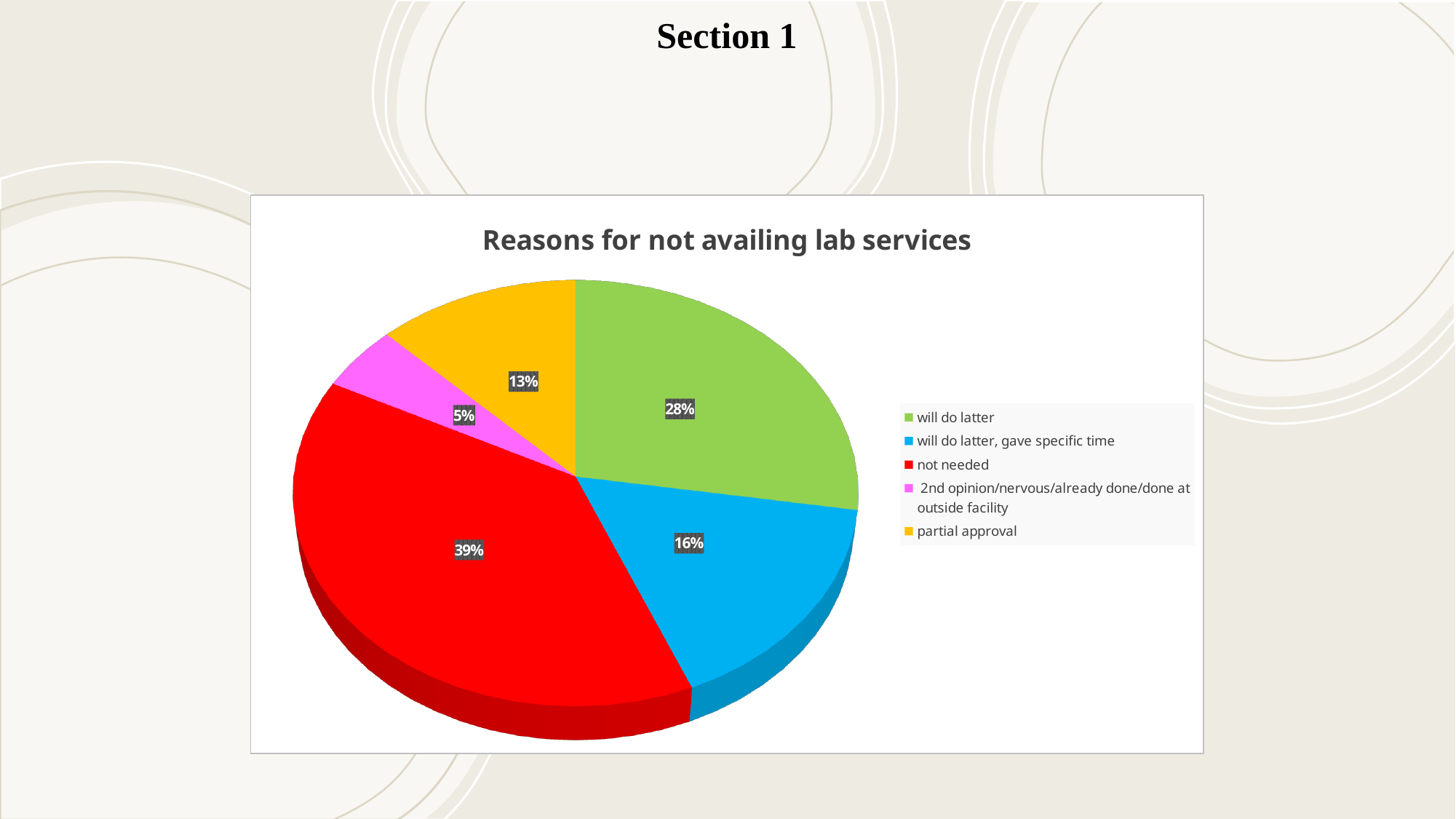
Which reason has the smallest share of the pie? 2nd opinion/nervous/already done/done at outside facility What is the title of the chart? Reasons for not availing lab services What share of the pie is '2nd opinion/nervous/already done/done at outside facility'? 5% What kind of chart is shown on the slide? pie chart Which reason has the largest share of the pie? not needed What share of the pie is 'not needed'? 39% How many slices does the pie chart have? 5 What share of the pie is 'partial approval'? 13% What is the difference between the shares for 'not needed' and 'will do latter'? 11% Which is larger, the share for 'partial approval' or the share for 'will do latter, gave specific time'? will do latter, gave specific time